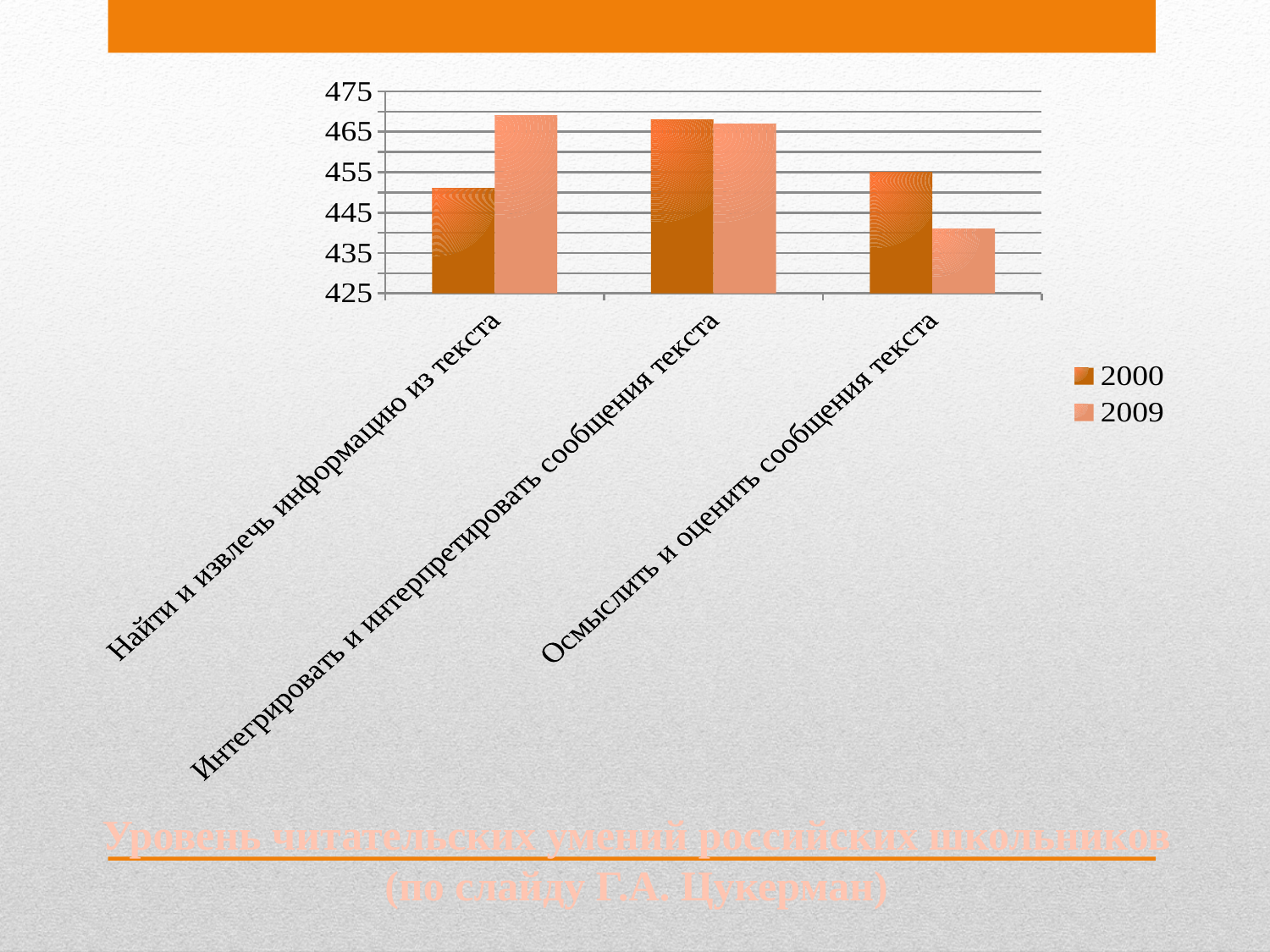
Which category has the lowest value in the 2009 series? Осмыслить и оценить сообщения текста What kind of chart is shown on the slide? Bar chart How many categories are shown on the x axis of the chart? 3 What is the title of the chart on the slide? Уровень читательских умений российских школьников (по слайду Г.А. Цукерман) How many series does the chart's legend list? 2 For 'Найти и извлечь информацию из текста', which year has the larger value, 2000 or 2009? 2009 Is the 2000 value for 'Найти и извлечь информацию из текста' greater or less than 445? greater Is the 2000 value for 'Интегрировать и интерпретировать сообщения текста' greater or less than 465? greater For 'Осмыслить и оценить сообщения текста', which year has the larger value, 2000 or 2009? 2000 Is the 2009 value for 'Осмыслить и оценить сообщения текста' greater or less than 445? less Which years are listed in the chart's legend? 2000 and 2009